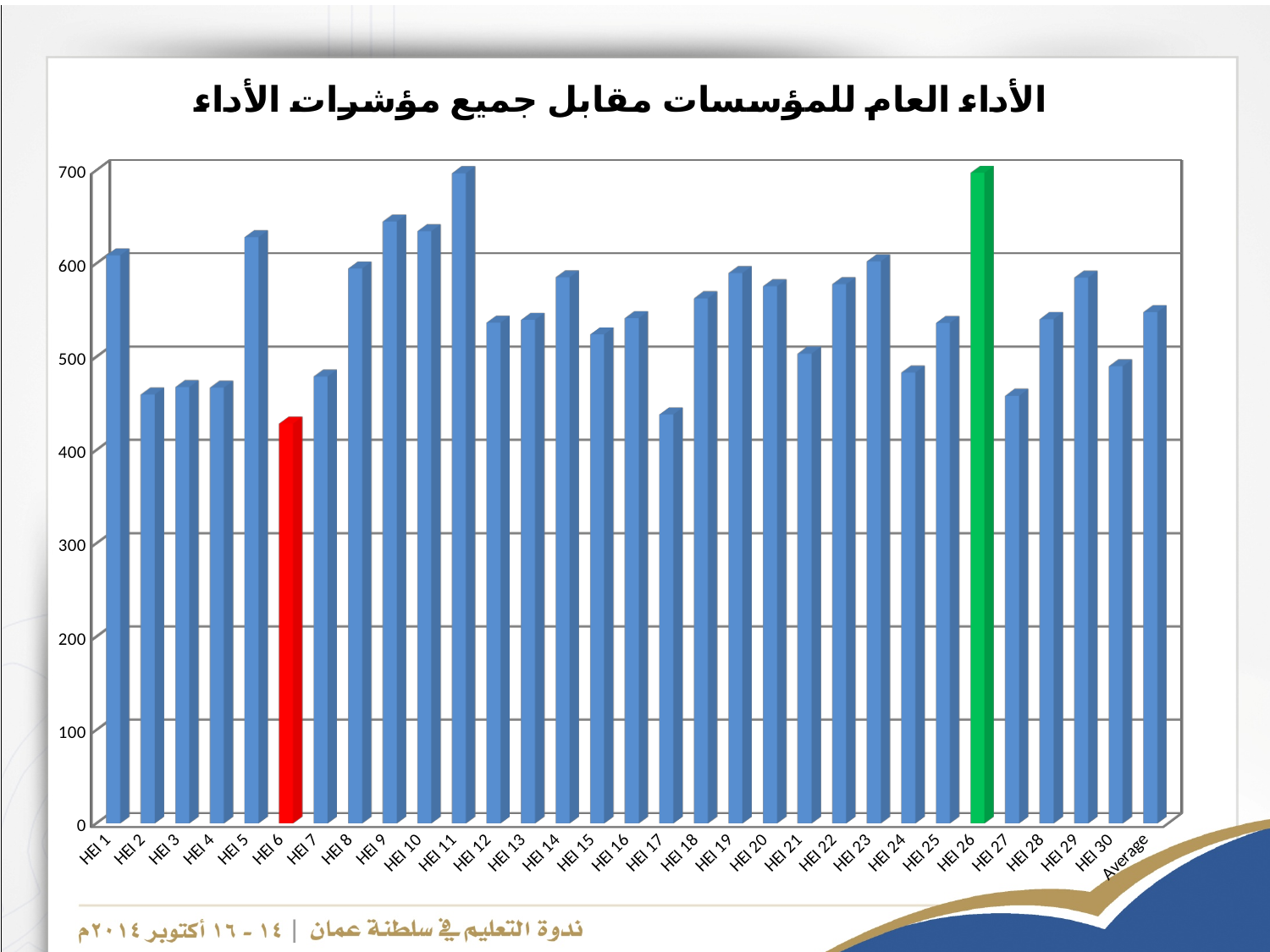
Is the value for HEI 9 greater or less than 600? greater What kind of chart is shown on the slide? bar chart Is the value for HEI 6 greater or less than 500? less What colour is the bar for HEI 26? green Is the value for HEI 5 greater or less than 600? greater Which is larger, the value for HEI 26 or the value for HEI 27? HEI 26 How many categories are plotted along the x axis of the chart? 31 Which is larger, the value for HEI 5 or the value for HEI 6? HEI 5 What colour is the bar for HEI 6? red